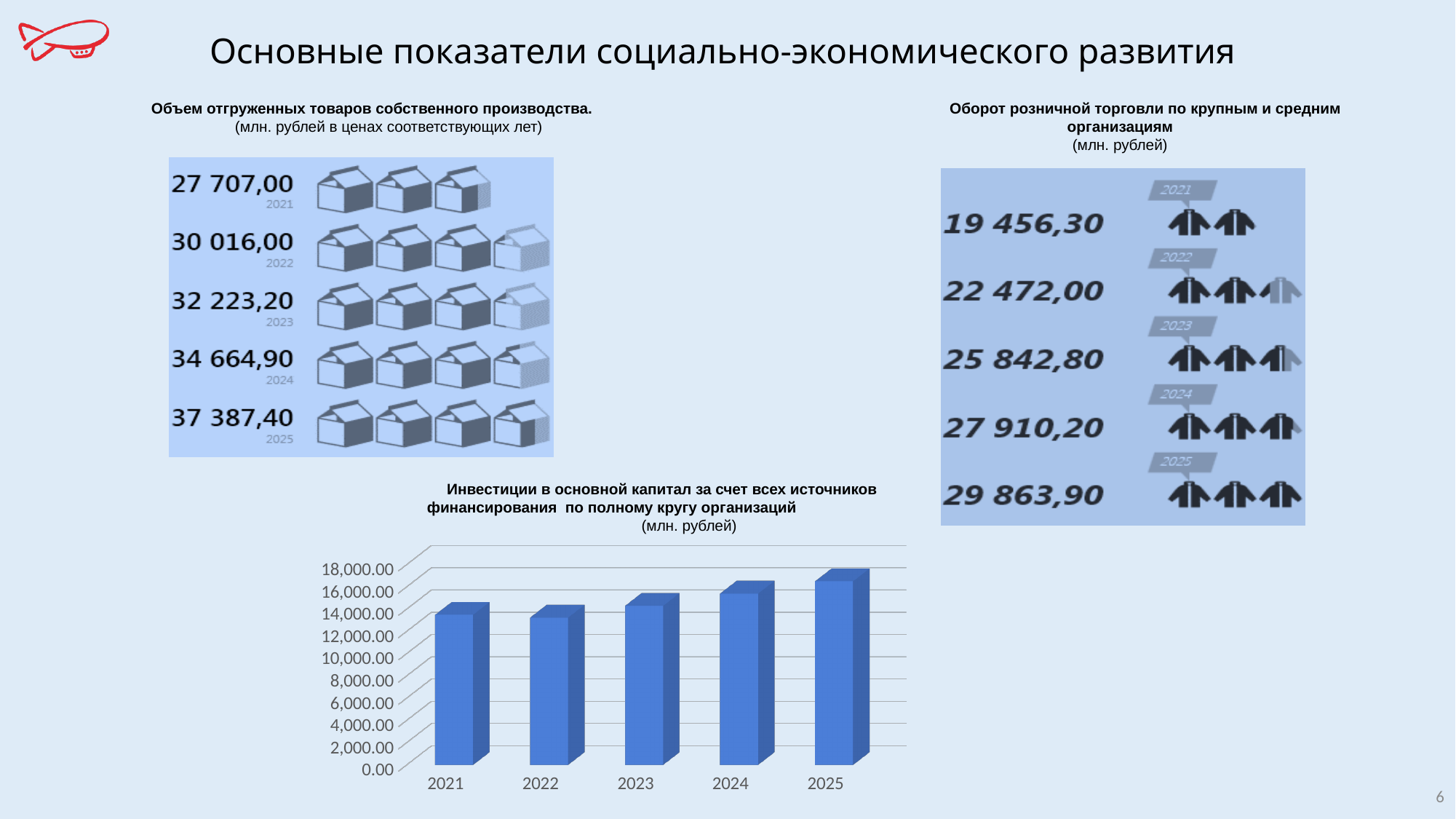
On the bottom chart 'Инвестиции в основной капитал', is the value for 2022 greater or less than 14,000.00? less On the chart 'Объем отгруженных товаров собственного производства', what is the value for 2021? 27 707,00 On the chart 'Объем отгруженных товаров собственного производства', which year has the highest value? 2025 On the chart 'Оборот розничной торговли по крупным и средним организациям', do the values rise or fall from 2021 to 2025? rise On the chart 'Объем отгруженных товаров собственного производства', what is the difference between the 2025 and 2021 values? 9 680,40 On the chart 'Оборот розничной торговли по крупным и средним организациям', what is the difference between the 2025 and 2021 values? 10 407,60 On the chart 'Оборот розничной торговли по крупным и средним организациям', what is the value for 2024? 27 910,20 On the bottom chart 'Инвестиции в основной капитал', which year has the highest bar? 2025 On the chart 'Объем отгруженных товаров собственного производства', what is the value for 2023? 32 223,20 On the chart 'Оборот розничной торговли по крупным и средним организациям', which year has the lowest value? 2021 On the bottom chart 'Инвестиции в основной капитал', how many years are shown on the x axis? 5 What kind of chart is the bottom chart 'Инвестиции в основной капитал'? bar chart